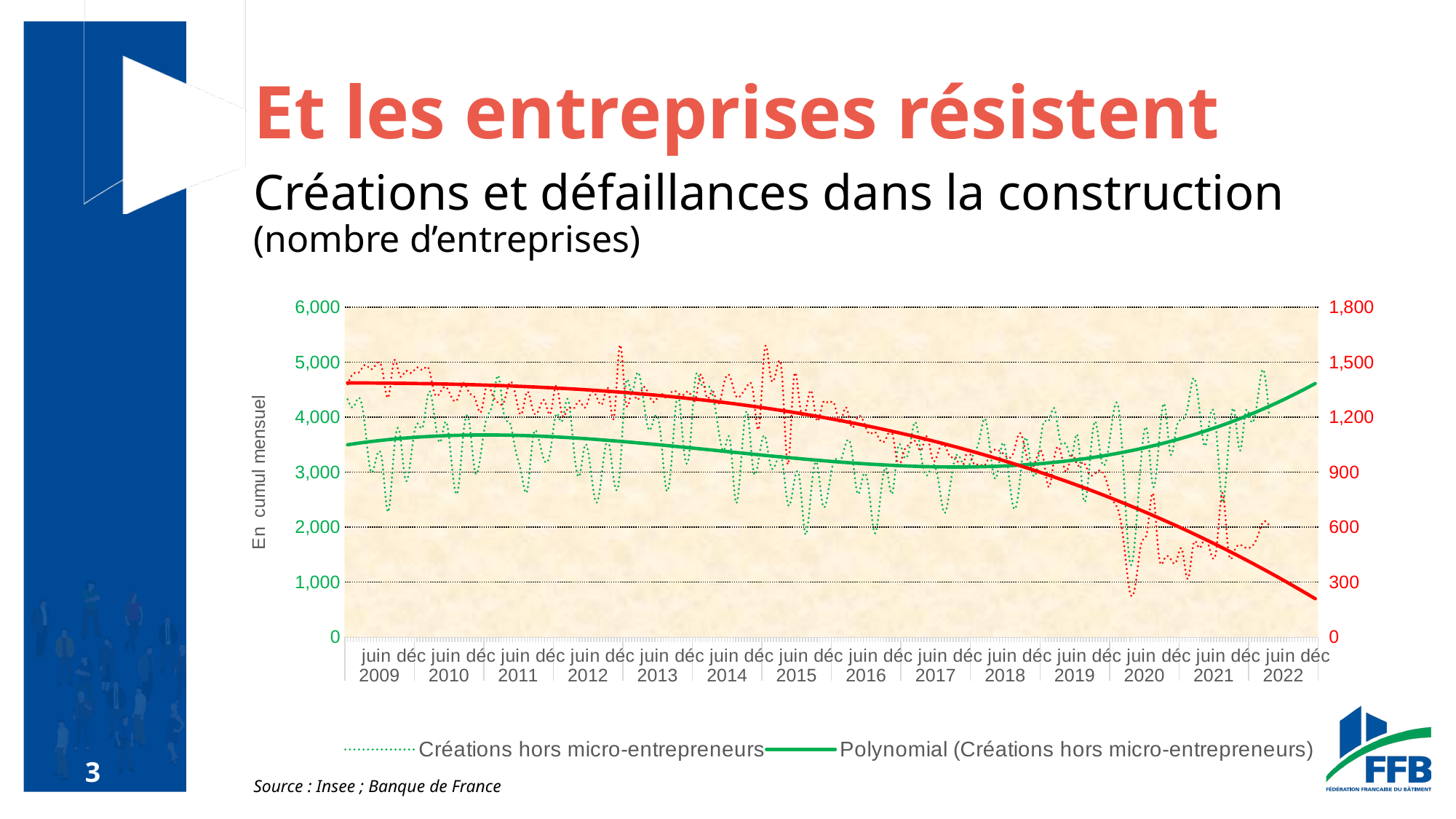
What is the highest value shown on the left vertical axis? 6,000 What is the highest value shown on the right vertical axis? 1,800 Does the solid red trend line rise or fall from 2009 to the end of 2022? fall How many series does the legend list? 2 Is the value of the solid red trend line at the end of 2022 greater or less than 300 on the right axis? less How many years are labelled along the x axis of the chart? 14 What is the label on the left vertical axis of the chart? En cumul mensuel Does the solid green polynomial trend line rise or fall between 2018 and the end of 2022? rise What are the two entries listed in the chart legend? Créations hors micro-entrepreneurs; Polynomial (Créations hors micro-entrepreneurs) Is the value of the solid green polynomial line at the end of 2022 greater or less than 4,000 on the left axis? greater What kind of chart is shown on the slide? line chart Is the value of the solid red trend line at the start of 2009 greater or less than 1,200 on the right axis? greater